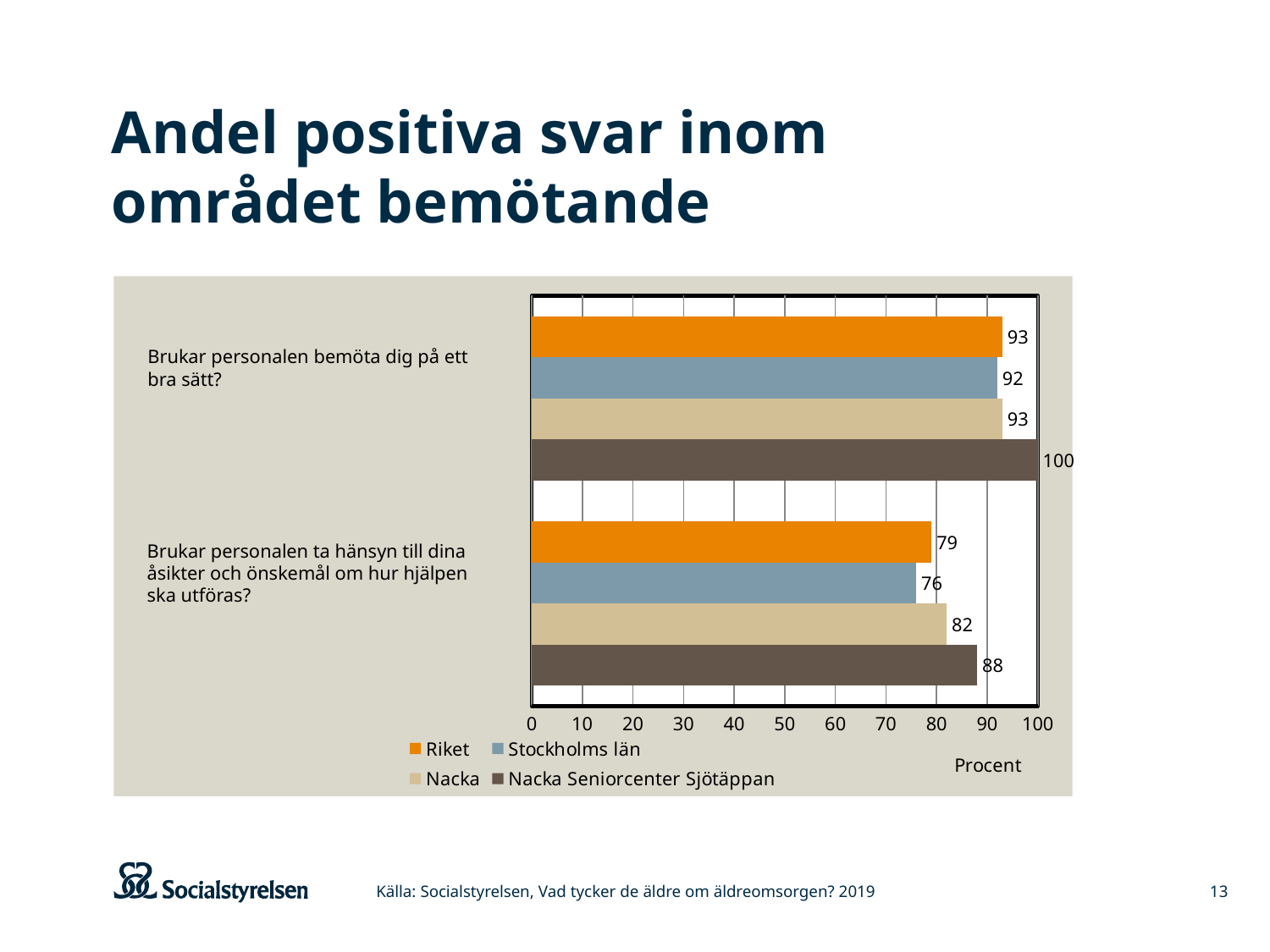
Which series has the highest value for the question "Brukar personalen ta hänsyn till dina åsikter och önskemål om hur hjälpen ska utföras?"? Nacka Seniorcenter Sjötäppan What type of chart is shown on the slide? bar chart How many questions (categories) are shown on the chart? 2 What is the value for Stockholms län for the question "Brukar personalen ta hänsyn till dina åsikter och önskemål om hur hjälpen ska utföras?"? 76 How many series does the legend list? 4 What is the value for Nacka Seniorcenter Sjötäppan for the question "Brukar personalen bemöta dig på ett bra sätt?"? 100 What is the value for Riket for the question "Brukar personalen ta hänsyn till dina åsikter och önskemål om hur hjälpen ska utföras?"? 79 What is the difference between the Nacka Seniorcenter Sjötäppan value and the Stockholms län value for the question "Brukar personalen bemöta dig på ett bra sätt?"? 8 What unit is shown on the horizontal axis of the chart? Procent For the question "Brukar personalen bemöta dig på ett bra sätt?", which is larger: the value for Riket or the value for Stockholms län? Riket What is the difference between the Nacka Seniorcenter Sjötäppan value and the Nacka value for the question "Brukar personalen ta hänsyn till dina åsikter och önskemål om hur hjälpen ska utföras?"? 6 Which series has the lowest value for the question "Brukar personalen ta hänsyn till dina åsikter och önskemål om hur hjälpen ska utföras?"? Stockholms län